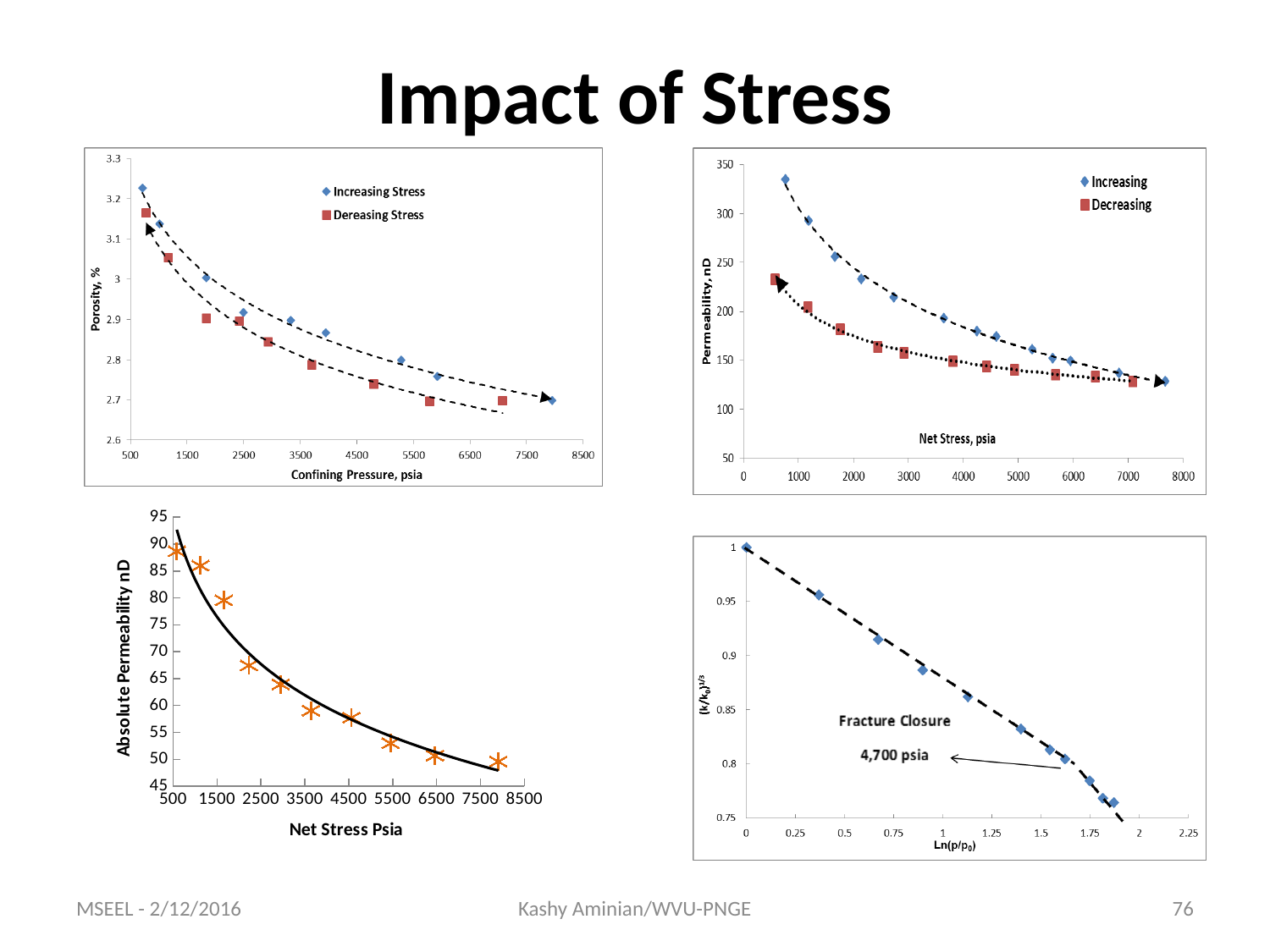
How many series does the legend of the top-left chart (Porosity, % vs Confining Pressure, psia) list? 2 What fracture closure pressure is annotated on the bottom-right chart ((k/k0)^1/3 vs Ln(p/p0))? 4,700 psia In the top-right chart (Permeability, nD vs Net Stress, psia), at a net stress of about 1000 psia, which series has the higher permeability, Increasing or Decreasing? Increasing In the bottom-left chart (Absolute Permeability nD vs Net Stress Psia), is the value at about 2300 psia greater or less than 65 nD? greater In the top-left chart (Porosity, % vs Confining Pressure, psia), does porosity rise or fall as confining pressure increases? fall In the top-right chart (Permeability, nD vs Net Stress, psia), is the first Decreasing point (near 600 psia) greater or less than 250 nD? less In the top-right chart (Permeability, nD vs Net Stress, psia), is the first Increasing point (near 600 psia) greater or less than 300 nD? greater How many data points are plotted in the bottom-left chart (Absolute Permeability nD vs Net Stress Psia)? 10 What are the two legend entries in the top-right chart (Permeability, nD vs Net Stress, psia)? Increasing and Decreasing In the bottom-right chart ((k/k0)^1/3 vs Ln(p/p0)), do the values rise or fall as Ln(p/p0) increases? fall What kind of chart is the bottom-left chart (Absolute Permeability nD vs Net Stress Psia)? scatter chart In the bottom-right chart ((k/k0)^1/3 vs Ln(p/p0)), what is the value of (k/k0)^1/3 at Ln(p/p0) = 0? 1